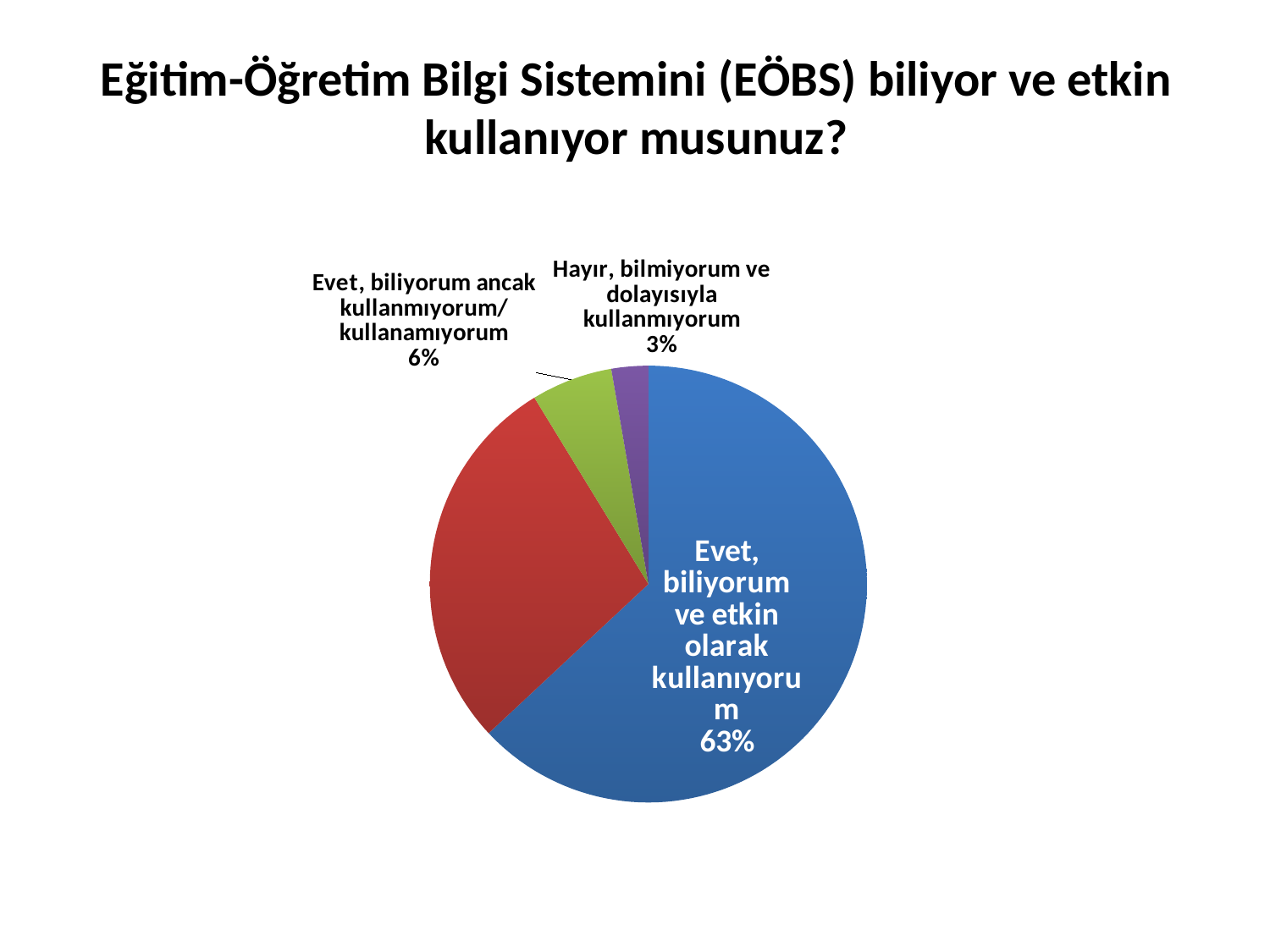
What percentage is shown for "Hayır, bilmiyorum ve dolayısıyla kullanmıyorum"? 3% What share of the pie does the slice "Evet, biliyorum ve etkin olarak kullanıyorum" represent? 63% What kind of chart is shown on the slide? pie chart What is the difference in percentage points between "Evet, biliyorum ve etkin olarak kullanıyorum" and "Hayır, bilmiyorum ve dolayısıyla kullanmıyorum"? 60 What is the title of the slide? Eğitim-Öğretim Bilgi Sistemini (EÖBS) biliyor ve etkin kullanıyor musunuz? How many slices does the pie chart have? 4 Which category has the largest slice of the pie? Evet, biliyorum ve etkin olarak kullanıyorum Which is larger: the slice for "Evet, biliyorum ancak kullanmıyorum/kullanamıyorum" or the slice for "Hayır, bilmiyorum ve dolayısıyla kullanmıyorum"? Evet, biliyorum ancak kullanmıyorum/kullanamıyorum Which is larger: the red slice or the green slice? the red slice What percentage is shown for "Evet, biliyorum ancak kullanmıyorum/kullanamıyorum"? 6% Which category has the smallest slice of the pie? Hayır, bilmiyorum ve dolayısıyla kullanmıyorum What is the difference in percentage points between "Evet, biliyorum ancak kullanmıyorum/kullanamıyorum" and "Hayır, bilmiyorum ve dolayısıyla kullanmıyorum"? 3